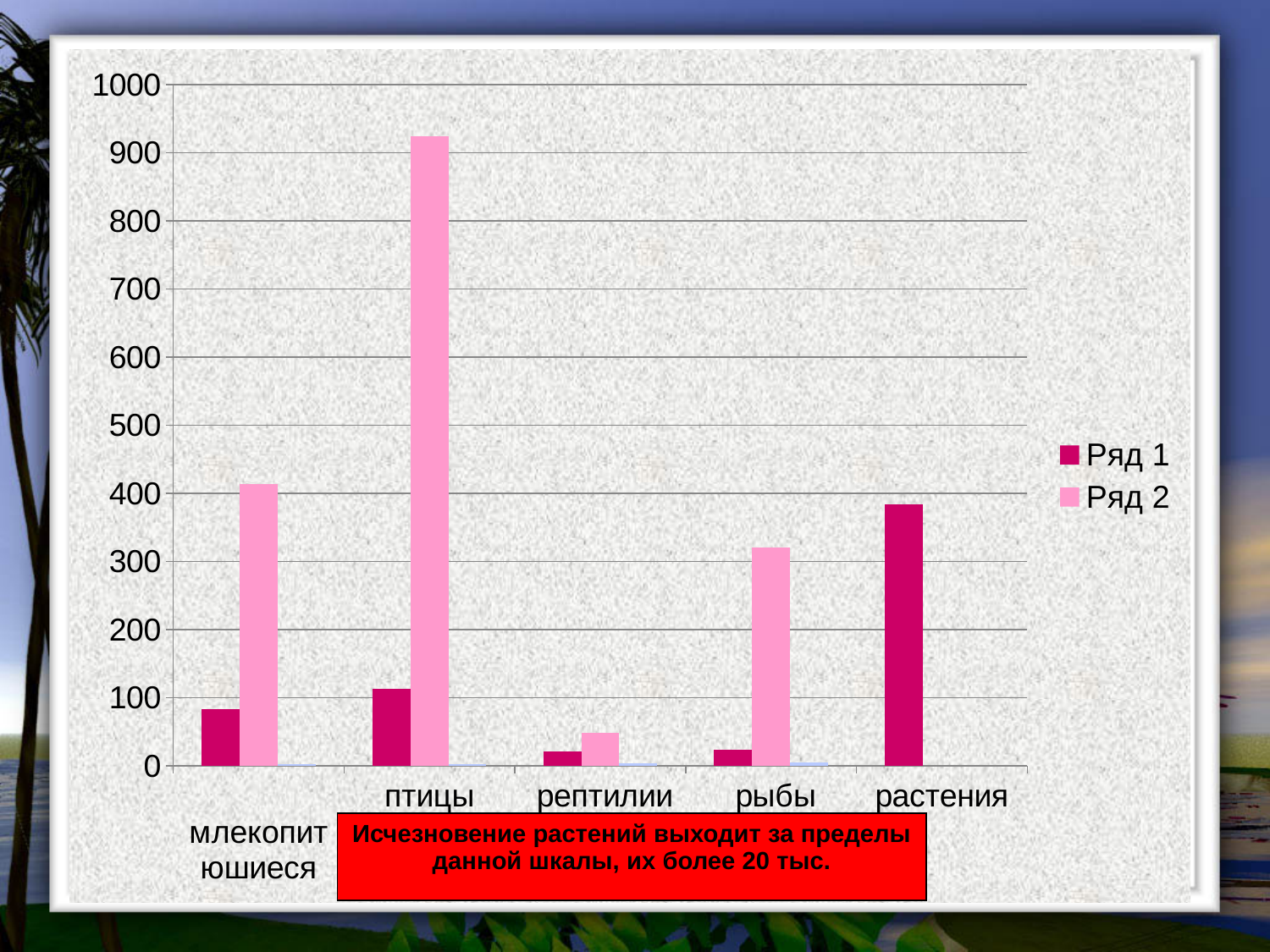
For Ряд 2, which is larger: the value for птицы or the value for рыбы? птицы What are the two entries listed in the chart's legend? Ряд 1 and Ряд 2 Is the Ряд 2 value for птицы greater or less than 900? greater Is the Ряд 2 value for рыбы greater or less than 300? greater Which category has the highest value for Ряд 2? птицы Is the Ряд 2 value for млекопитающиеся greater or less than 400? greater How many series does the chart's legend list? 2 How many categories are shown on the x axis of the chart? 5 What kind of chart is shown on the slide? bar chart Which category has the highest value for Ряд 1? растения